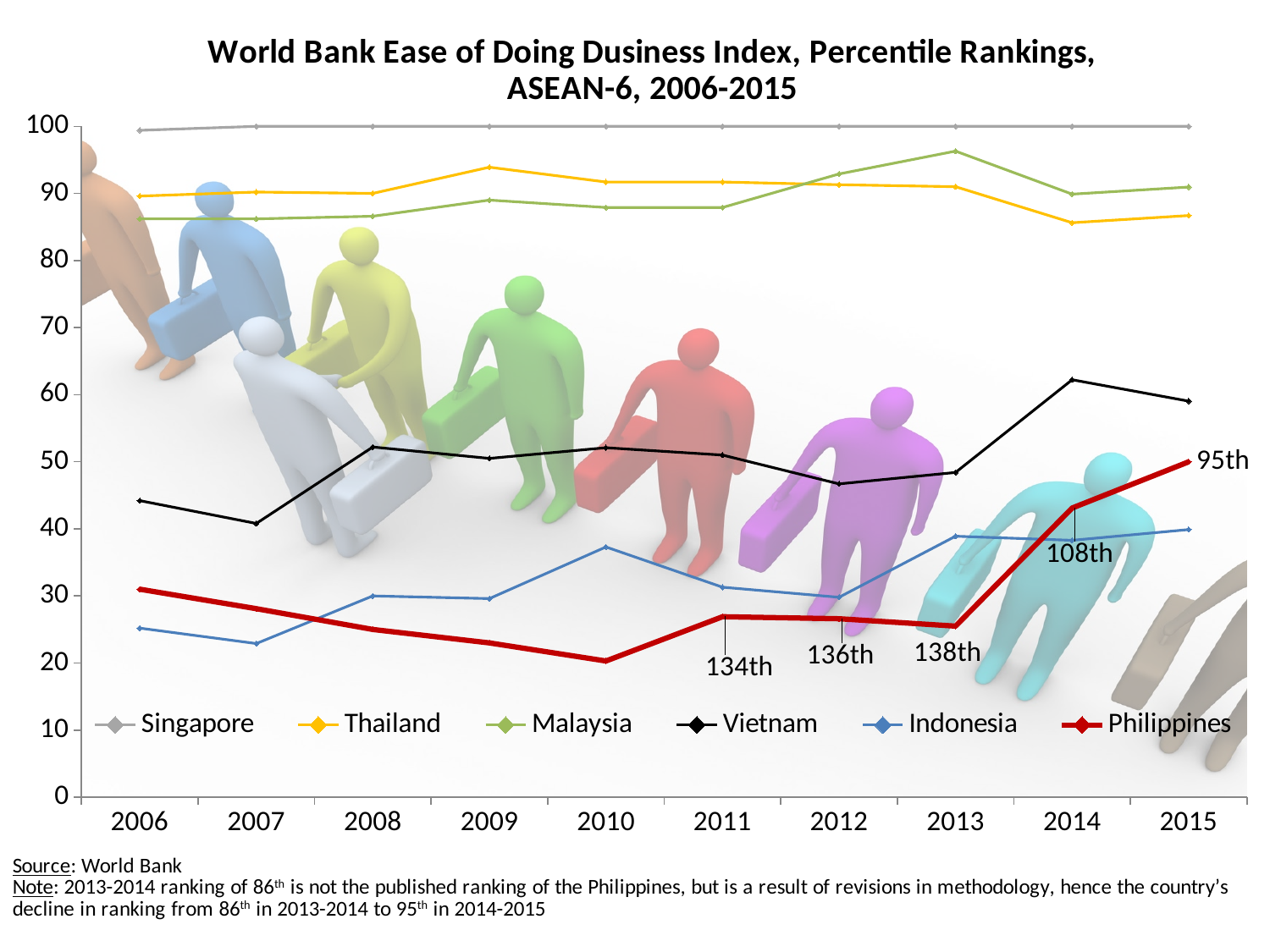
Which country has the lowest percentile ranking in 2010? Philippines How many years are shown on the x axis? 10 How many series does the legend list? 6 In 2013, which is higher, Vietnam or Indonesia? Vietnam Does the Philippines line rise or fall from 2013 to 2015? rises What kind of chart is shown on the slide? line chart What label is printed on the Philippines line at 2015? 95th What label is printed on the Philippines line at 2011? 134th Which country has the highest percentile ranking in 2015? Singapore Is the value for Indonesia in 2007 greater or less than 30? less Is the value for Vietnam in 2014 greater or less than 60? greater Is the value for Malaysia in 2013 greater or less than 90? greater